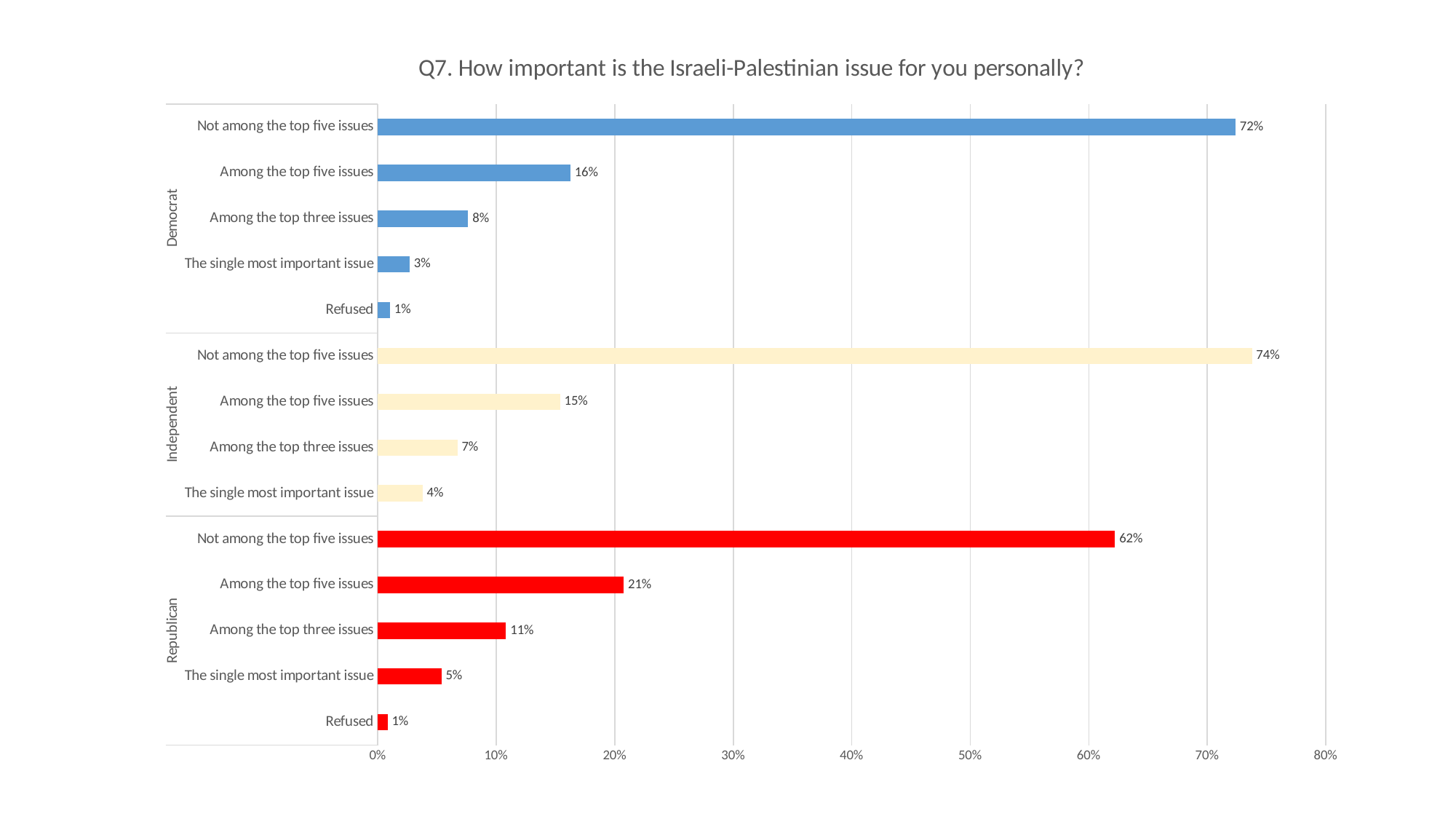
What is the difference between the Independent and Republican shares for 'Not among the top five issues'? 12% Which group has the highest share saying the issue is not among the top five issues? Independent Which group has the lowest share saying the issue is not among the top five issues? Republican What percentage of Independents said the issue is the single most important issue? 4% Is the Republican value for 'Not among the top five issues' greater or less than 70%? less What kind of chart is shown on the slide? Bar chart What colour are the bars for the Republican group? Red Which is larger: the Democrat share for 'Among the top three issues' or the Republican share for 'Among the top three issues'? Republican What percentage of Republicans said the issue is among the top five issues? 21% What percentage of Democrats said the Israeli-Palestinian issue is not among the top five issues? 72% How many bars are shown for the Independent group? 4 What is the title of the chart? Q7. How important is the Israeli-Palestinian issue for you personally?